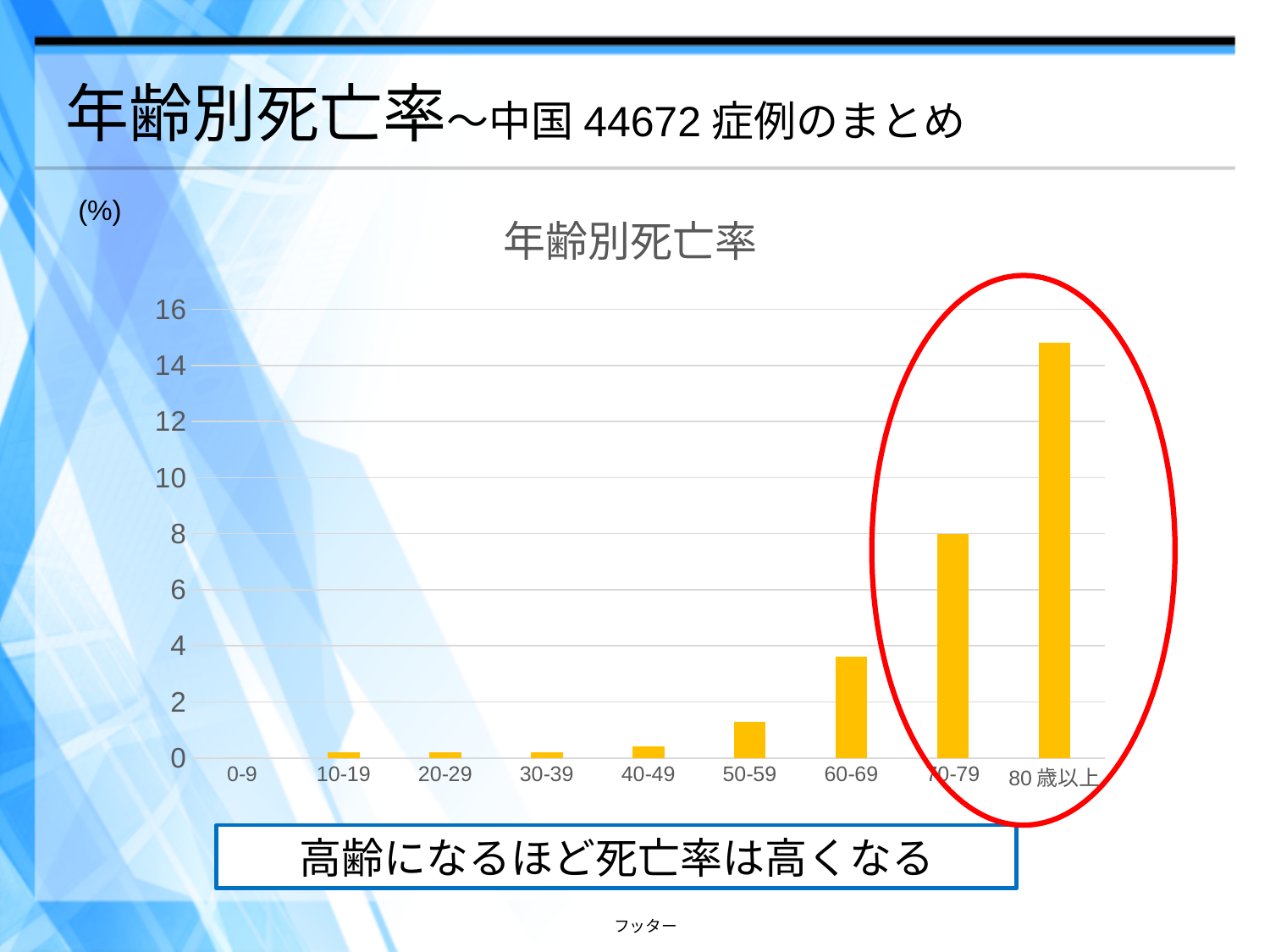
Is the value for 70-79 greater or less than 6? greater Which age category has the lowest value in the chart? 0-9 What kind of chart is shown on the slide? bar chart Is the value for 60-69 greater or less than 4? less How many age categories are shown on the x axis of the chart? 9 Is the value for 80歳以上 greater or less than 14? greater Which two age categories are circled in red on the chart? 70-79 and 80歳以上 What is the title of the chart? 年齢別死亡率 Which has a larger value, 70-79 or 60-69? 70-79 Which age category has the highest value in the chart? 80歳以上 Do the values rise or fall as age increases along the x axis? rise